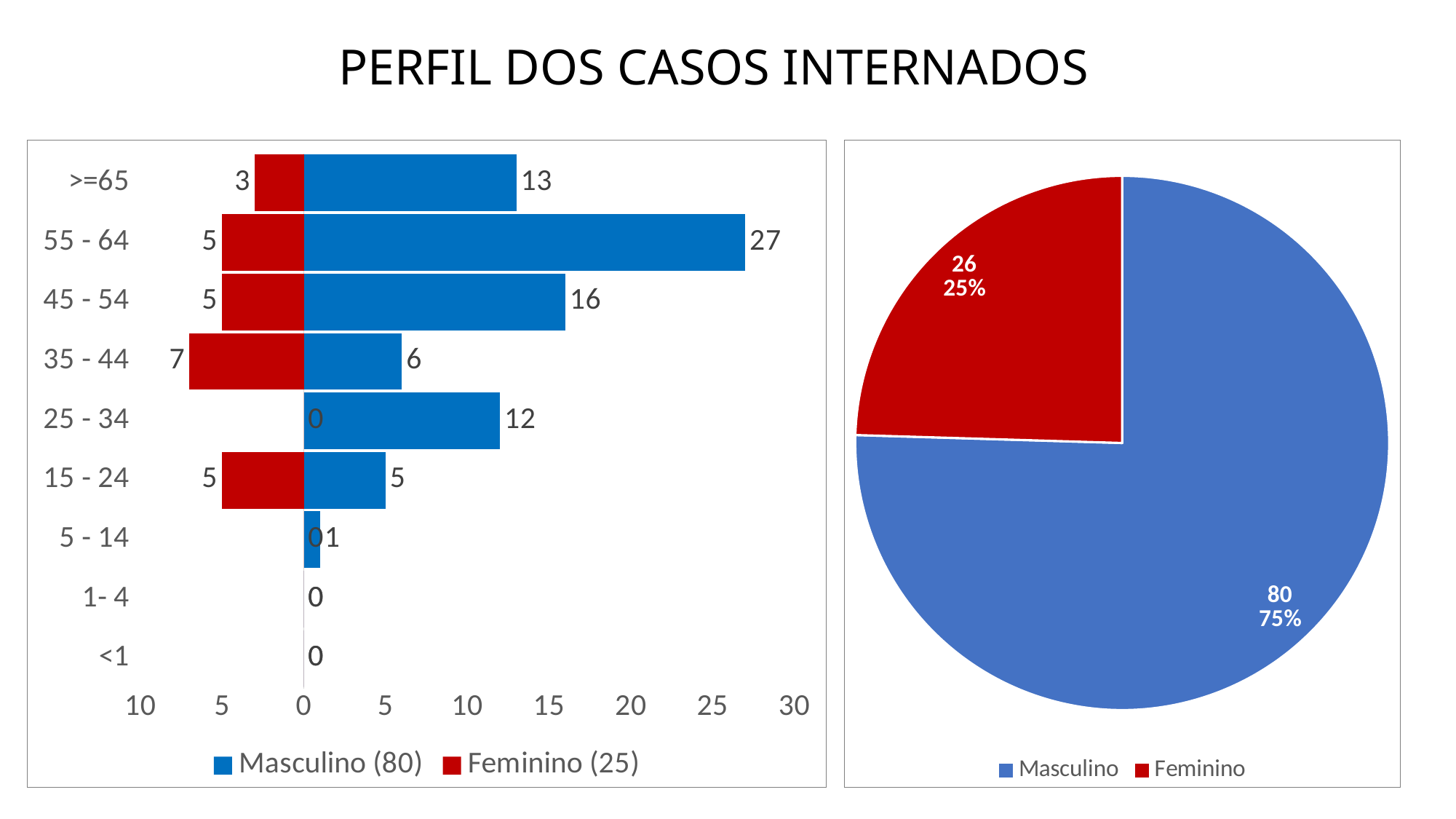
In the pie chart on the right, what is the value shown for Masculino? 80 In the bar chart on the left, what is the Feminino value for the 35 - 44 age group? 7 In the bar chart on the left, how many age groups are shown on the vertical axis? 9 In the bar chart on the left, which age group has the highest Feminino value? 35 - 44 In the bar chart on the left, what is the difference between the Masculino and Feminino values for the 45 - 54 age group? 11 In the bar chart on the left, how many series does the legend list? 2 In the bar chart on the left, which age group has the highest Masculino value? 55 - 64 What kind of chart is the chart on the left? Bar chart What is the title of the slide? PERFIL DOS CASOS INTERNADOS In the pie chart on the right, what share of the pie is Feminino? 25% In the bar chart on the left, what is the Masculino value for the 55 - 64 age group? 27 In the bar chart on the left, which is larger for the 35 - 44 age group, the Masculino value or the Feminino value? Feminino